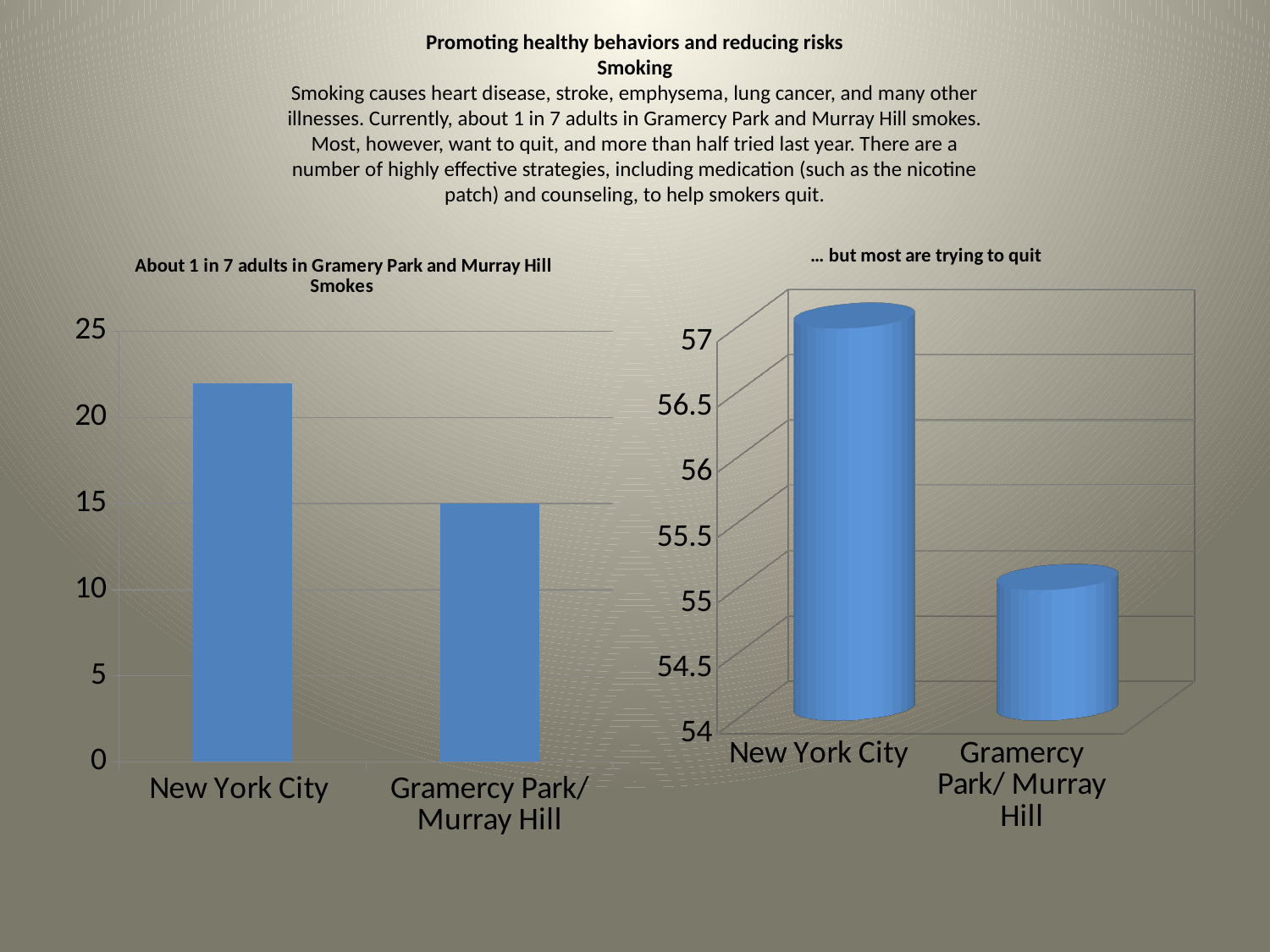
How many categories are shown on the left chart? 2 On the right chart, is the value for Gramercy Park/ Murray Hill greater or less than 56? less On the left chart, is the value for New York City greater or less than 20? greater What kind of chart is the left chart? bar chart On the right chart, is the value for Gramercy Park/ Murray Hill greater or less than 54.5? greater On the chart titled "… but most are trying to quit", which category has the higher value? New York City On the chart titled "About 1 in 7 adults in Gramery Park and Murray Hill Smokes", which category has the higher value? New York City On the chart titled "About 1 in 7 adults in Gramery Park and Murray Hill Smokes", which category has the lower value? Gramercy Park/ Murray Hill What is the title of the right chart? … but most are trying to quit